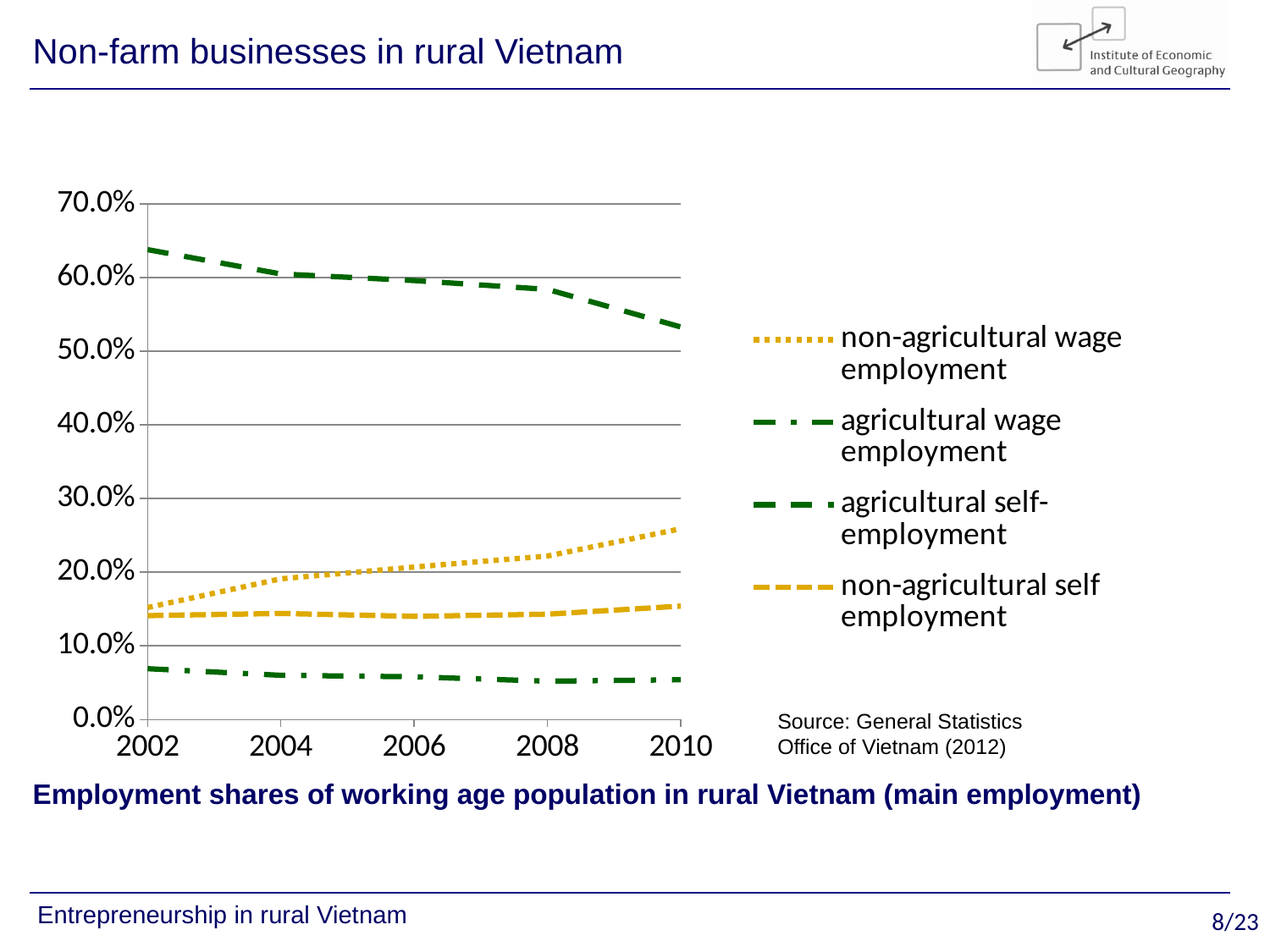
In 2010, which is larger: non-agricultural wage employment or non-agricultural self employment? non-agricultural wage employment How many year labels are shown on the x axis? 5 Is the value for agricultural self-employment in 2002 greater or less than 60.0%? greater What kind of chart is shown on the slide? line chart Does the non-agricultural wage employment series rise or fall from 2002 to 2010? rise Is the value for agricultural wage employment in 2010 greater or less than 10.0%? less What source is cited for the chart data? General Statistics Office of Vietnam (2012) How many series does the legend list? 4 Which series has the highest value in 2010? agricultural self-employment Is the value for non-agricultural wage employment in 2010 greater or less than 20.0%? greater Which series has the lowest value in 2002? agricultural wage employment Does the agricultural self-employment series rise or fall from 2002 to 2010? fall